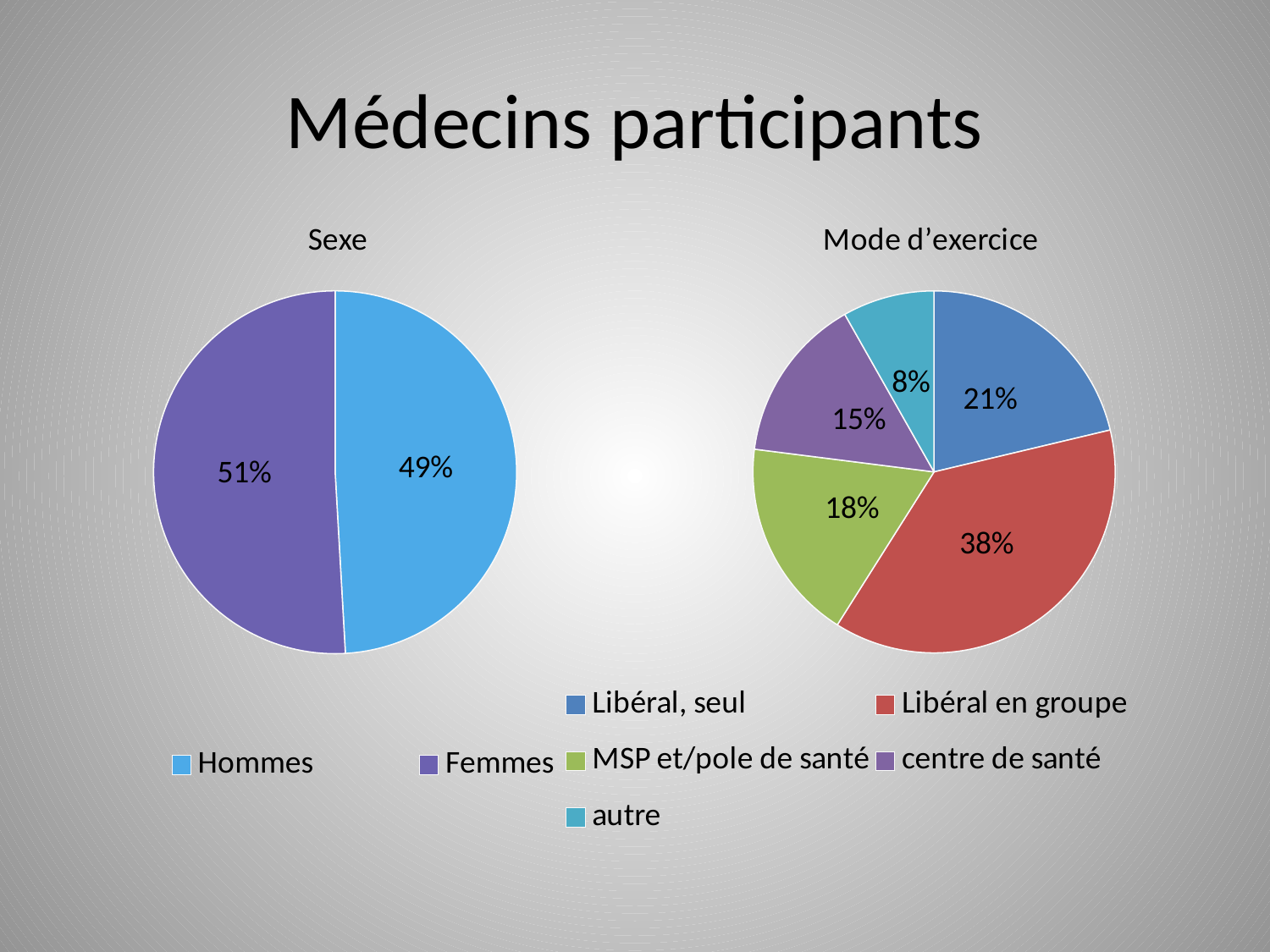
In the 'Mode d'exercice' chart, what share is 'Libéral, seul'? 21% In the 'Sexe' chart, what share of participants are Hommes? 49% In the 'Mode d'exercice' chart, what share is 'Libéral en groupe'? 38% What kind of chart is the 'Sexe' chart? Pie chart In the 'Mode d'exercice' chart, what is the difference in percentage points between 'Libéral en groupe' and 'centre de santé'? 23 In the 'Mode d'exercice' chart, which category has the largest share? Libéral en groupe In the 'Mode d'exercice' chart, what share is 'MSP et/pole de santé'? 18% In the 'Sexe' chart, what share of participants are Femmes? 51% In the 'Sexe' chart, what is the difference in percentage points between Femmes and Hommes? 2 In the 'Sexe' chart, which category has the larger share, Hommes or Femmes? Femmes In the 'Mode d'exercice' chart, which category has the smallest share? autre In the 'Mode d'exercice' chart, how many categories are shown? 5